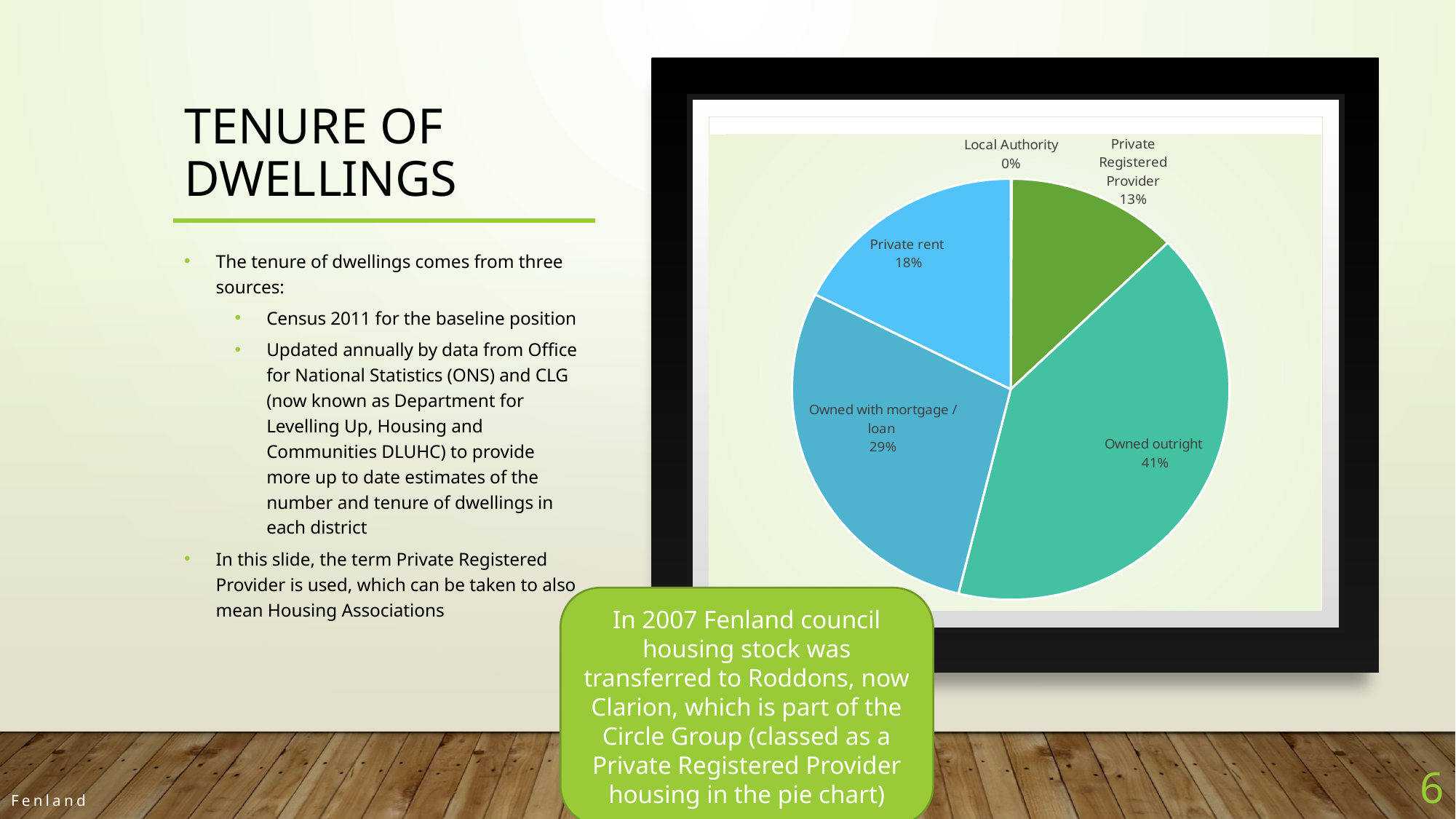
What kind of chart is shown on the slide? pie chart How many tenure categories are shown in the pie chart? 5 What share of dwellings is Local Authority? 0% What share of dwellings is Owned with mortgage / loan? 29% What is the combined share of Owned outright and Owned with mortgage / loan? 70% What is the difference in percentage points between Owned outright and Owned with mortgage / loan? 12 Which tenure category has the largest share of the pie? Owned outright What share of dwellings is Private rent? 18% What share of dwellings is Owned outright? 41% What share of dwellings is Private Registered Provider? 13% Which tenure category has the smallest share of the pie? Local Authority Which is larger, the share for Private rent or the share for Private Registered Provider? Private rent